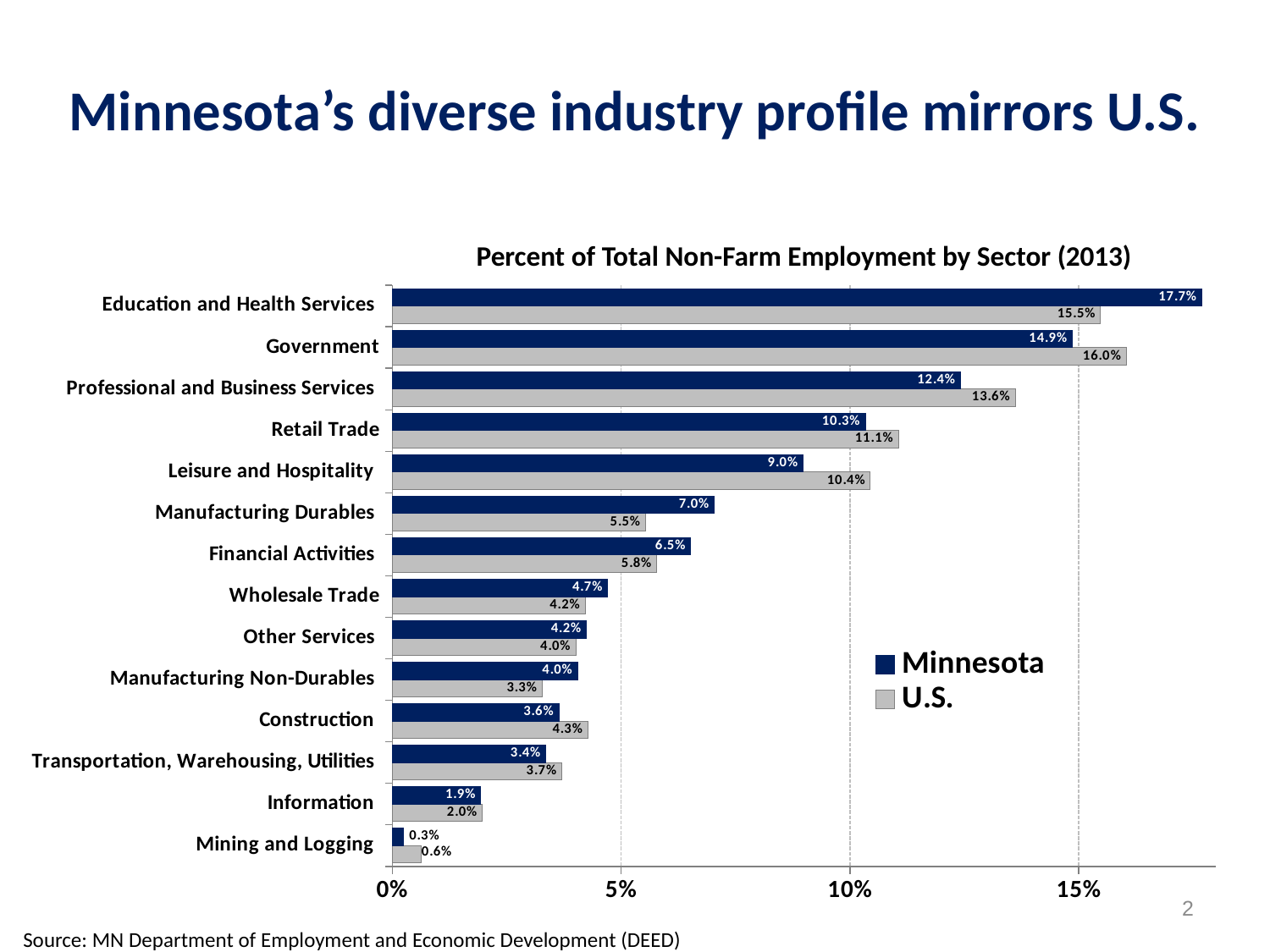
Which sector has the highest Minnesota value? Education and Health Services What is the U.S. value for Manufacturing Durables? 5.5% What is the title of the chart? Percent of Total Non-Farm Employment by Sector (2013) How many series does the legend list? 2 Which is larger for Leisure and Hospitality, the Minnesota value or the U.S. value? U.S. What is the difference between the Minnesota and U.S. values for Professional and Business Services? 1.2% What is the U.S. value for Government? 16.0% What kind of chart is shown on the slide? Bar chart How many sectors are shown on the chart? 14 What is the Minnesota value for Education and Health Services? 17.7% Is the Minnesota value for Retail Trade greater or less than 10%? greater Which sector has the lowest U.S. value? Mining and Logging